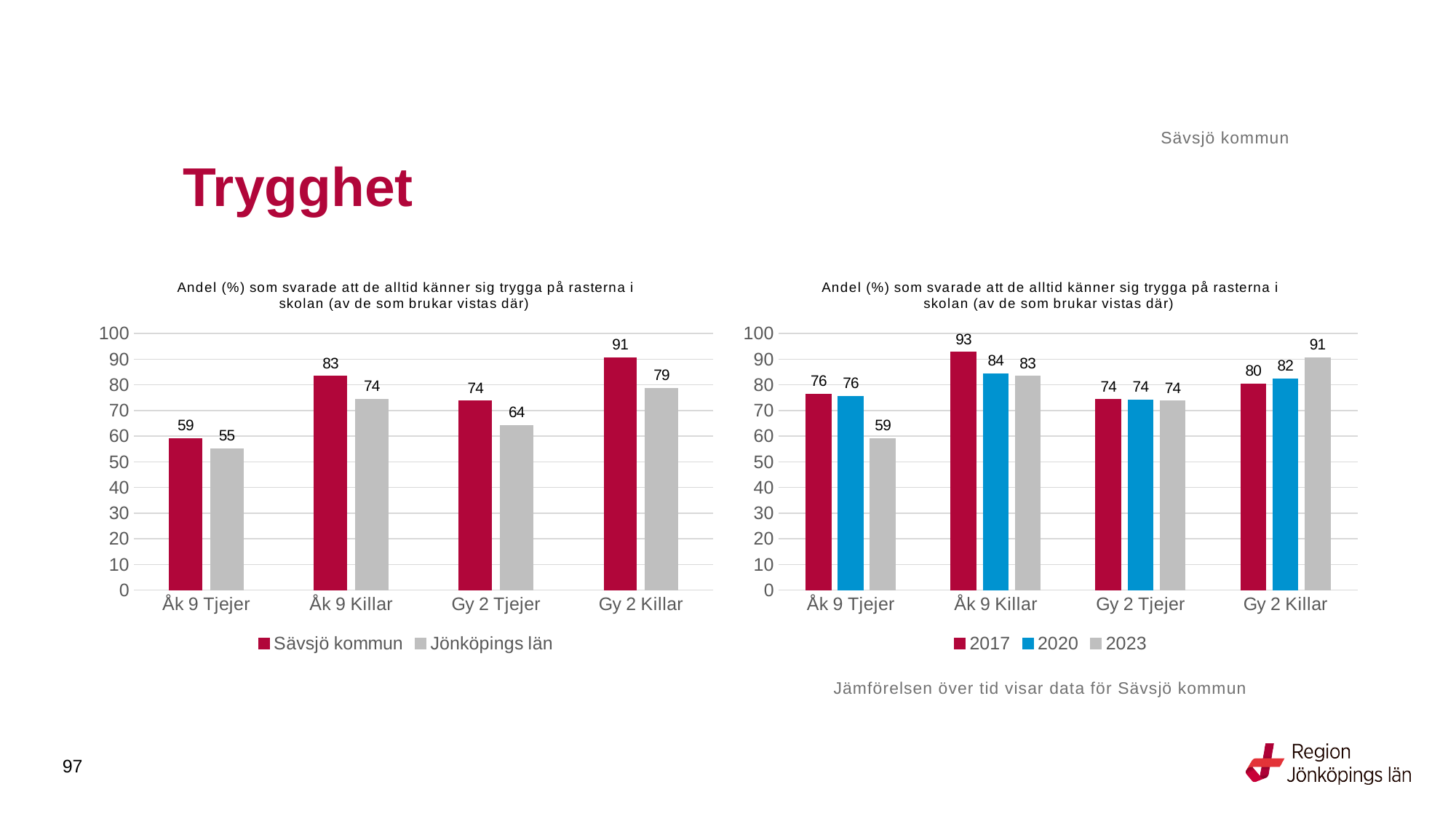
In the right chart, how many categories are shown on the x axis? 4 In the left chart, how many series does the legend list? 2 In the left chart, which category has the highest value for Sävsjö kommun? Gy 2 Killar In the left chart, what is the value for Sävsjö kommun for Åk 9 Tjejer? 59 In the right chart, what is the value for 2023 for Åk 9 Tjejer? 59 In the left chart, what is the value for Jönköpings län for Gy 2 Tjejer? 64 In the left chart, which category has the lowest value for Jönköpings län? Åk 9 Tjejer What kind of chart is the right chart? Bar chart In the left chart, what is the difference between Sävsjö kommun and Jönköpings län for Åk 9 Killar? 9 In the right chart, what is the difference between 2017 and 2023 for Åk 9 Tjejer? 17 In the right chart, which is larger for Gy 2 Killar: 2017 or 2023? 2023 In the right chart, what is the value for 2017 for Åk 9 Killar? 93